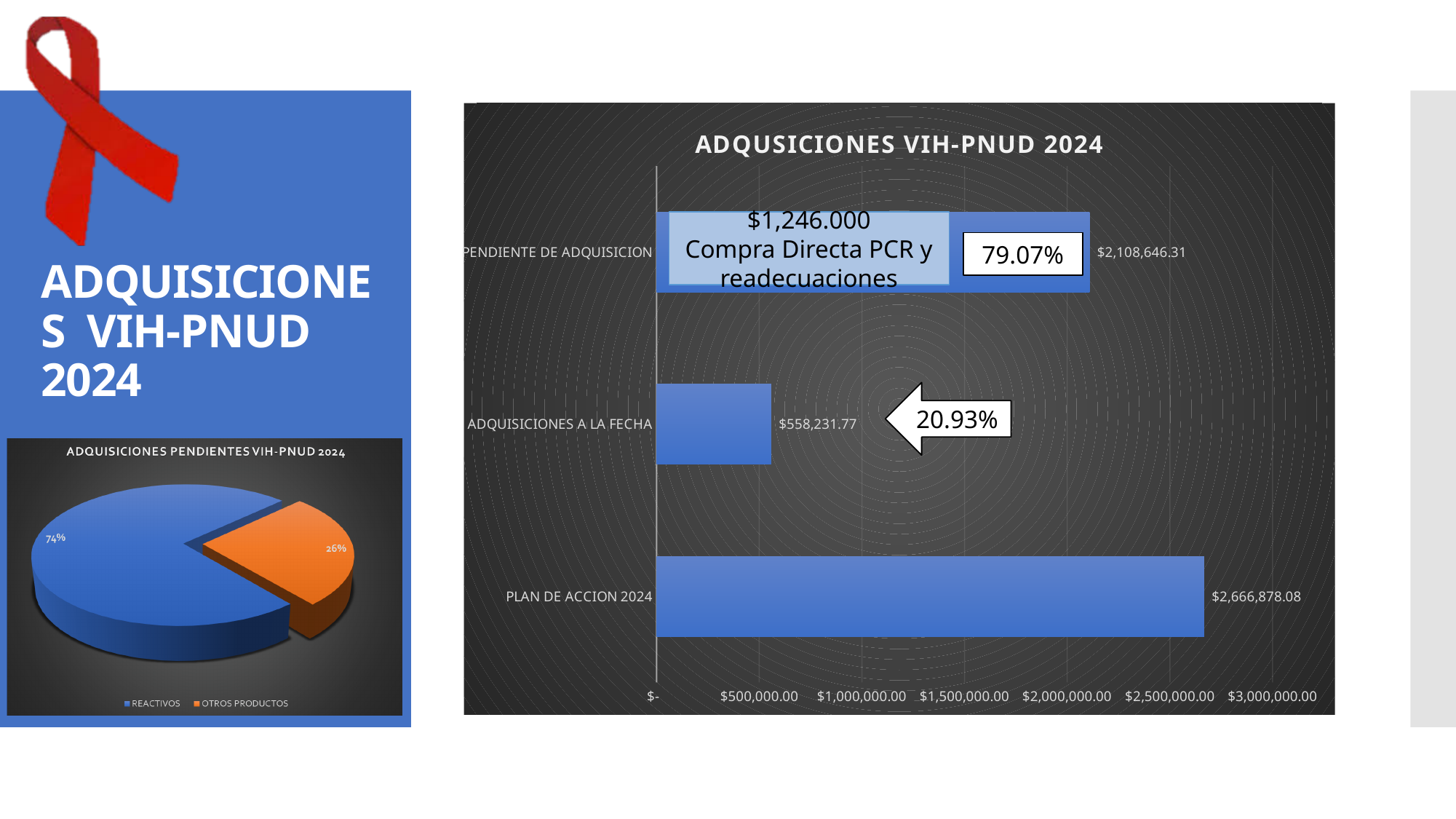
In the pie chart titled ADQUISICIONES PENDIENTES VIH-PNUD 2024, what share does REACTIVOS have? 74% In the bar chart titled ADQUSICIONES VIH-PNUD 2024, what is the value for ADQUISICIONES A LA FECHA? $558,231.77 In the bar chart titled ADQUSICIONES VIH-PNUD 2024, which is larger: PENDIENTE DE ADQUISICION or ADQUISICIONES A LA FECHA? PENDIENTE DE ADQUISICION What kind of chart is the chart titled ADQUSICIONES VIH-PNUD 2024? Bar chart In the bar chart titled ADQUSICIONES VIH-PNUD 2024, what is the value for PENDIENTE DE ADQUISICION? $2,108,646.31 In the pie chart titled ADQUISICIONES PENDIENTES VIH-PNUD 2024, how many entries does the legend list? 2 In the bar chart titled ADQUSICIONES VIH-PNUD 2024, how many categories are shown? 3 In the bar chart titled ADQUSICIONES VIH-PNUD 2024, what is the value for PLAN DE ACCION 2024? $2,666,878.08 In the pie chart titled ADQUISICIONES PENDIENTES VIH-PNUD 2024, what share does OTROS PRODUCTOS have? 26% In the bar chart titled ADQUSICIONES VIH-PNUD 2024, what is the difference between PLAN DE ACCION 2024 and PENDIENTE DE ADQUISICION? $558,231.77 In the bar chart titled ADQUSICIONES VIH-PNUD 2024, which category has the highest value? PLAN DE ACCION 2024 In the bar chart titled ADQUSICIONES VIH-PNUD 2024, which category has the lowest value? ADQUISICIONES A LA FECHA